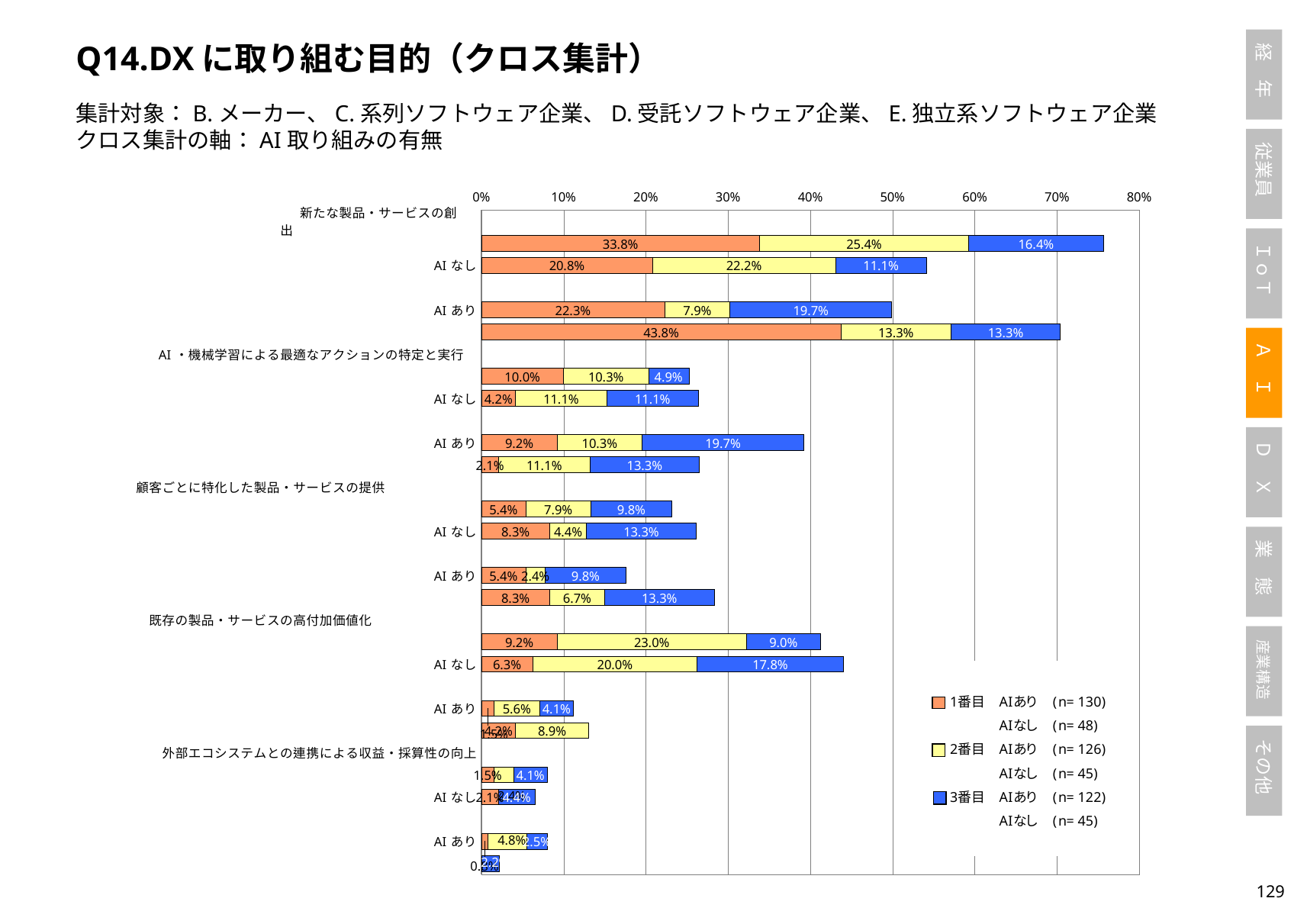
What is the highest value shown on the x axis? 80% What is the total of the topmost stacked bar? 75.6% What is the value of the yellow (2番目) segment of the second bar from the top? 22.2% Which has the larger orange (1番目) segment: the topmost bar or the second bar from the top? the topmost bar What is the difference between the orange segment of the topmost bar (33.8%) and the orange segment of the second bar (20.8%)? 13.0% What kind of chart is shown on the slide? bar chart According to the legend, what is the n for 1番目 AIあり? 130 What is the value of the orange (1番目) segment of the topmost bar? 33.8% What is the largest single orange (1番目) segment value shown in the chart? 43.8% What is the value of the blue (3番目) segment of the topmost bar? 16.4% What is the total of the second stacked bar from the top? 54.1% How many series does the legend list? 3